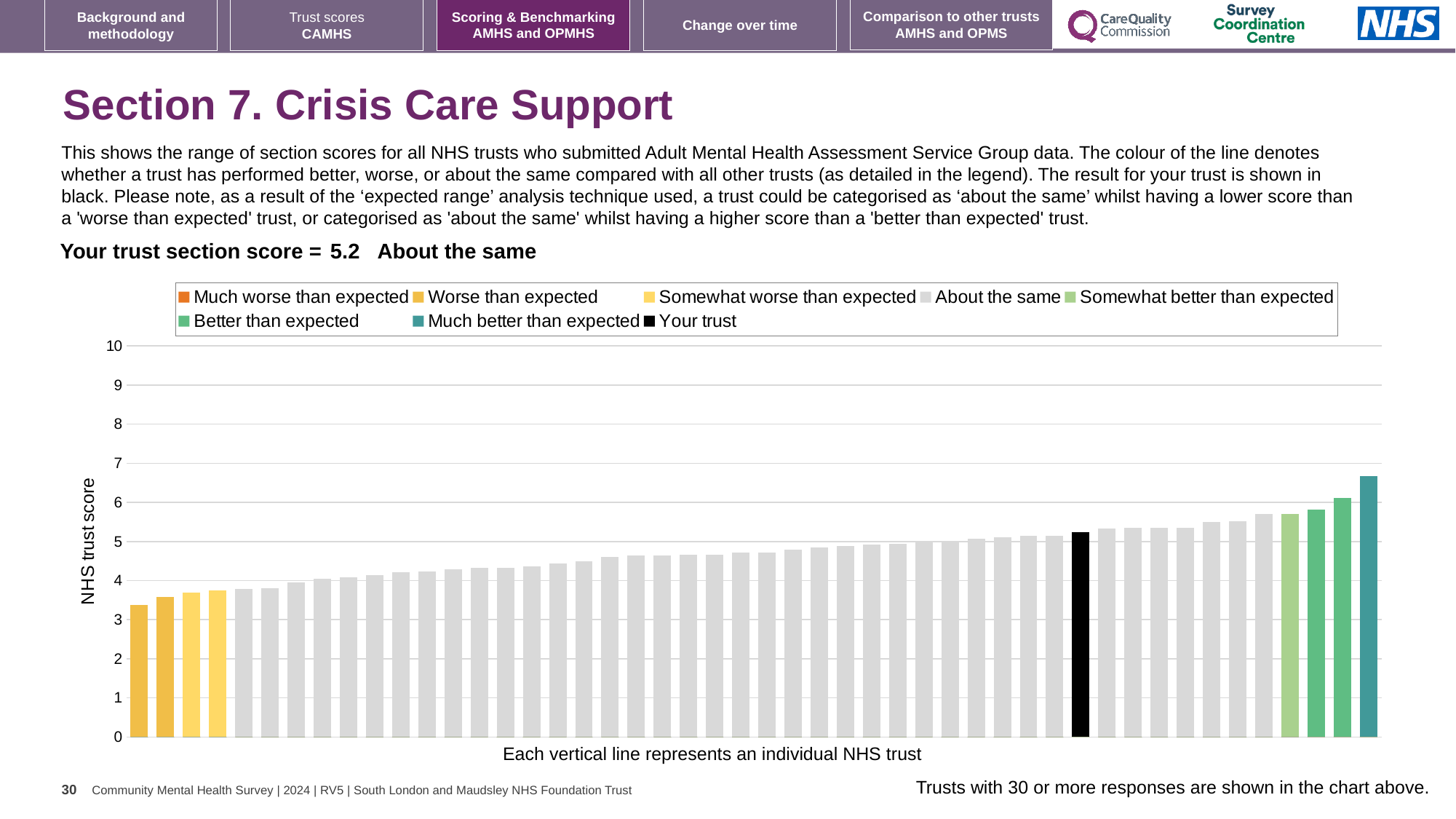
What is the section score for your trust shown on the slide? 5.2 What is the label on the vertical axis of the chart? NHS trust score Do the bar values rise or fall from left to right along the x axis? rise Is the value of the shortest bar in the chart greater or less than 4? less Which is larger: the value for your trust or the value of the tallest bar? the tallest bar What kind of chart is shown on the slide? bar chart How many entries does the chart legend list? 8 Is the value of the tallest bar in the chart greater or less than 6? greater How many bars are coloured as 'Much better than expected'? 1 Which legend category does the tallest bar in the chart belong to? Much better than expected What colour is the bar representing your trust? black Is the value for your trust (the black bar) greater or less than 5? greater